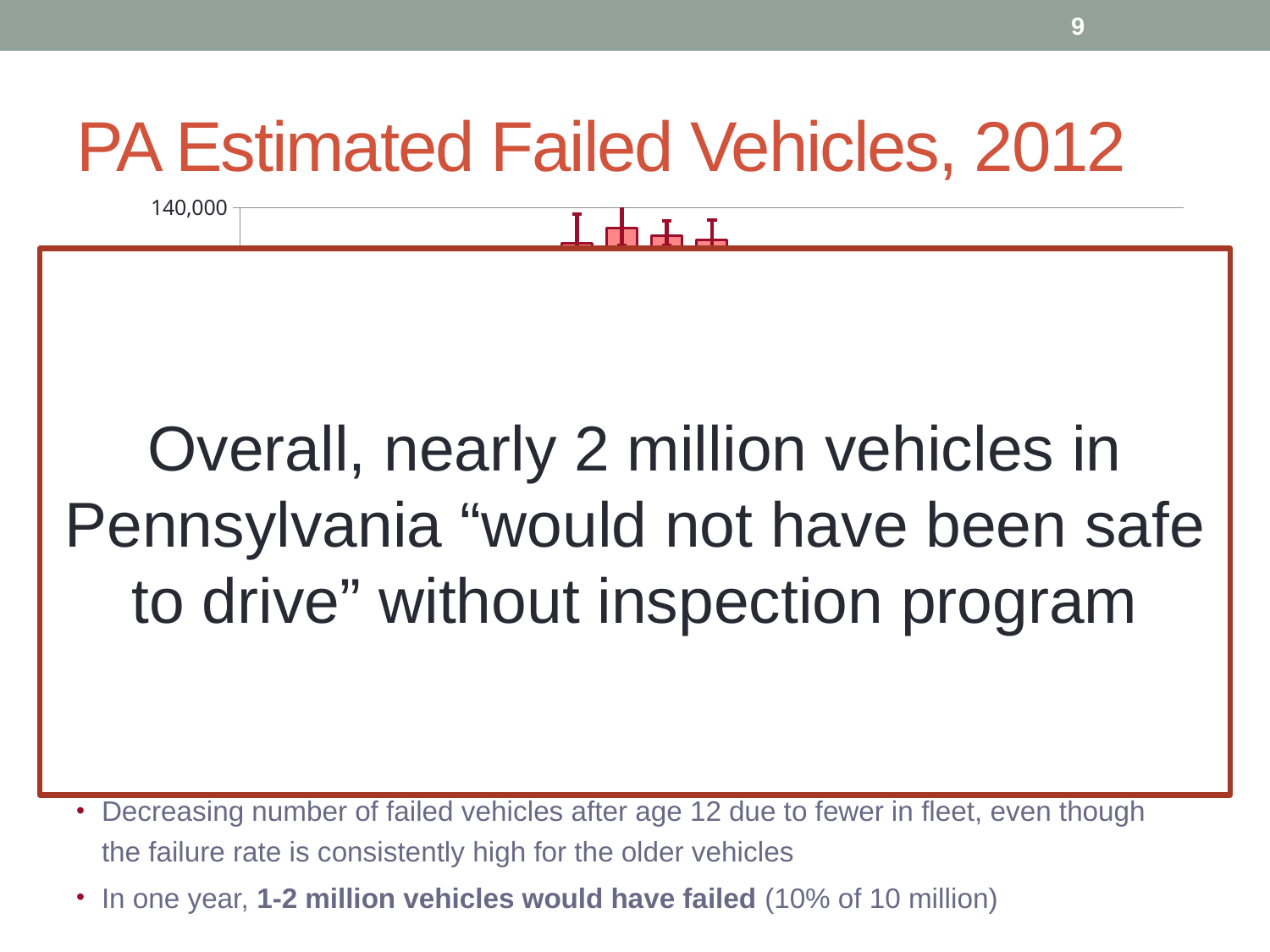
Do any of the visible bars in the chart reach above the 140,000 gridline? no What kind of chart is shown on the slide? bar chart What is the topmost value labelled on the chart's vertical axis? 140,000 What is the title of the chart on the slide? PA Estimated Failed Vehicles, 2012